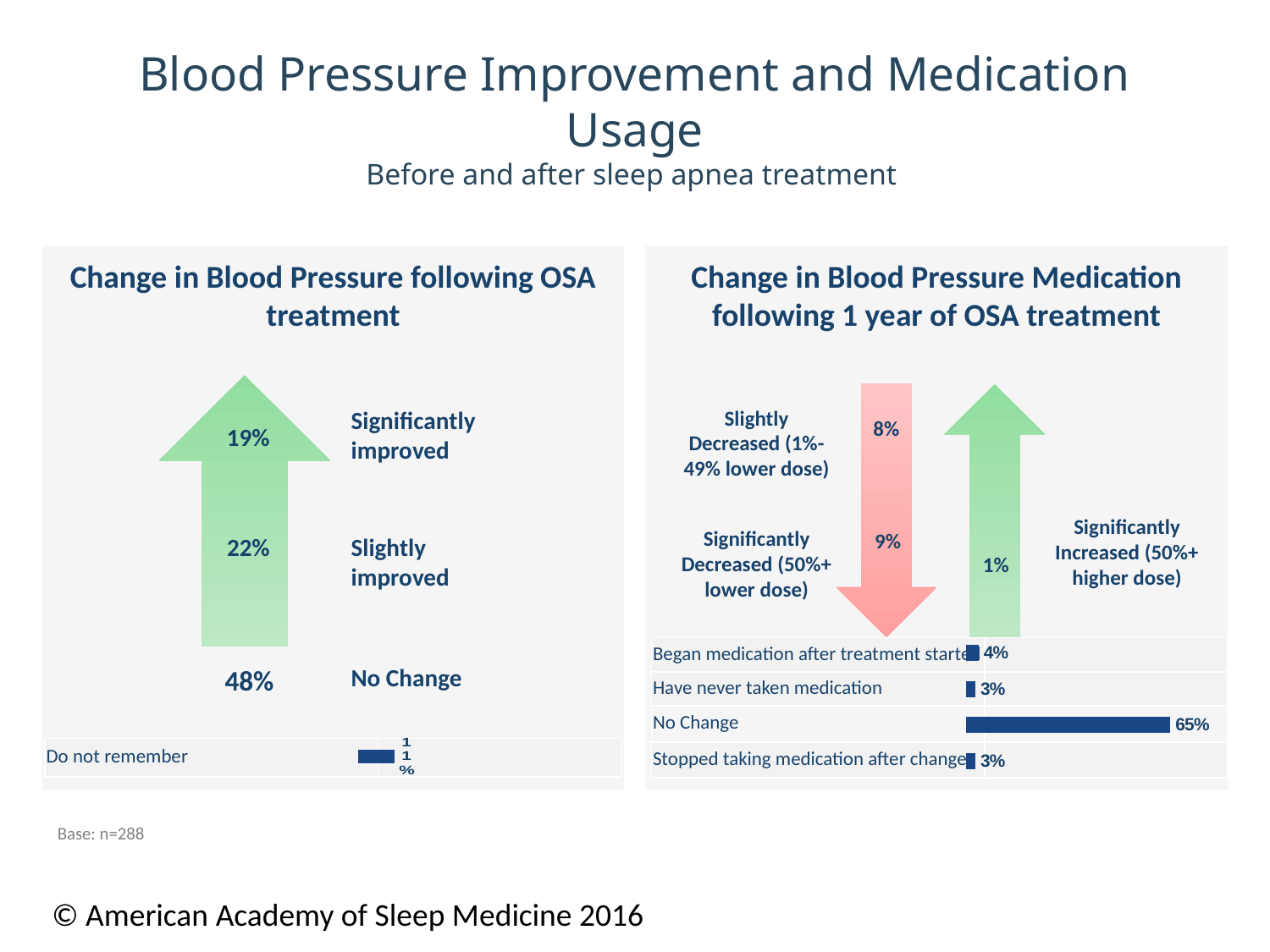
In the 'Change in Blood Pressure Medication following 1 year of OSA treatment' chart, what is the difference between 'No Change' and 'Began medication after treatment started'? 61% In the 'Change in Blood Pressure Medication following 1 year of OSA treatment' chart, what percentage reported 'No Change'? 65% In the 'Change in Blood Pressure Medication following 1 year of OSA treatment' chart, what percentage reported 'Significantly Decreased (50%+ lower dose)'? 9% In the 'Change in Blood Pressure following OSA treatment' chart, what is the difference between 'Slightly improved' and 'Significantly improved'? 3% In the 'Change in Blood Pressure Medication following 1 year of OSA treatment' chart, which category has the highest value? No Change In the 'Change in Blood Pressure Medication following 1 year of OSA treatment' chart, what percentage 'Began medication after treatment started'? 4% In the 'Change in Blood Pressure Medication following 1 year of OSA treatment' chart, what percentage reported 'Slightly Decreased (1%-49% lower dose)'? 8% In the 'Change in Blood Pressure Medication following 1 year of OSA treatment' chart, what percentage reported 'Significantly Increased (50%+ higher dose)'? 1% In the 'Change in Blood Pressure following OSA treatment' chart, which is larger: 'No Change' or 'Slightly improved'? No Change In the 'Change in Blood Pressure following OSA treatment' chart, what percentage of respondents reported 'No Change'? 48% In the 'Change in Blood Pressure following OSA treatment' chart, what percentage reported 'Significantly improved'? 19% In the 'Change in Blood Pressure following OSA treatment' chart, what percentage reported 'Slightly improved'? 22%